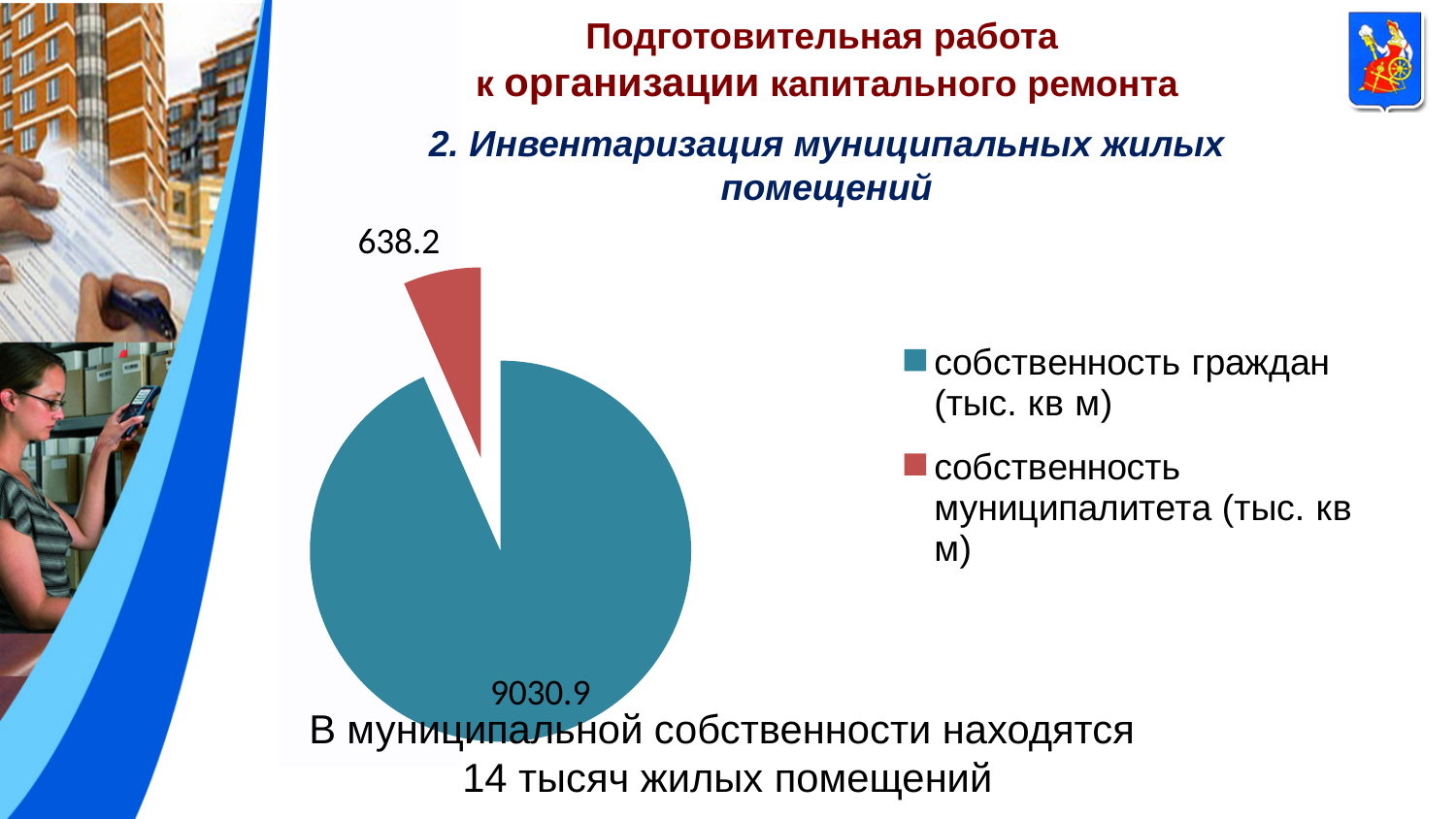
Which category has the largest slice of the pie? собственность граждан (тыс. кв м) What is the value for собственность граждан (тыс. кв м)? 9030.9 What type of chart is shown on the slide? pie chart Which category has the smallest slice of the pie? собственность муниципалитета (тыс. кв м) How many entries does the legend list? 2 What is the difference between the value for собственность граждан and the value for собственность муниципалитета? 8392.7 How many slices does the pie chart have? 2 Which is larger: собственность граждан or собственность муниципалитета? собственность граждан What colour is the slice for собственность муниципалитета? red What is the total of the two values shown in the pie chart? 9669.1 What is the value for собственность муниципалитета (тыс. кв м)? 638.2